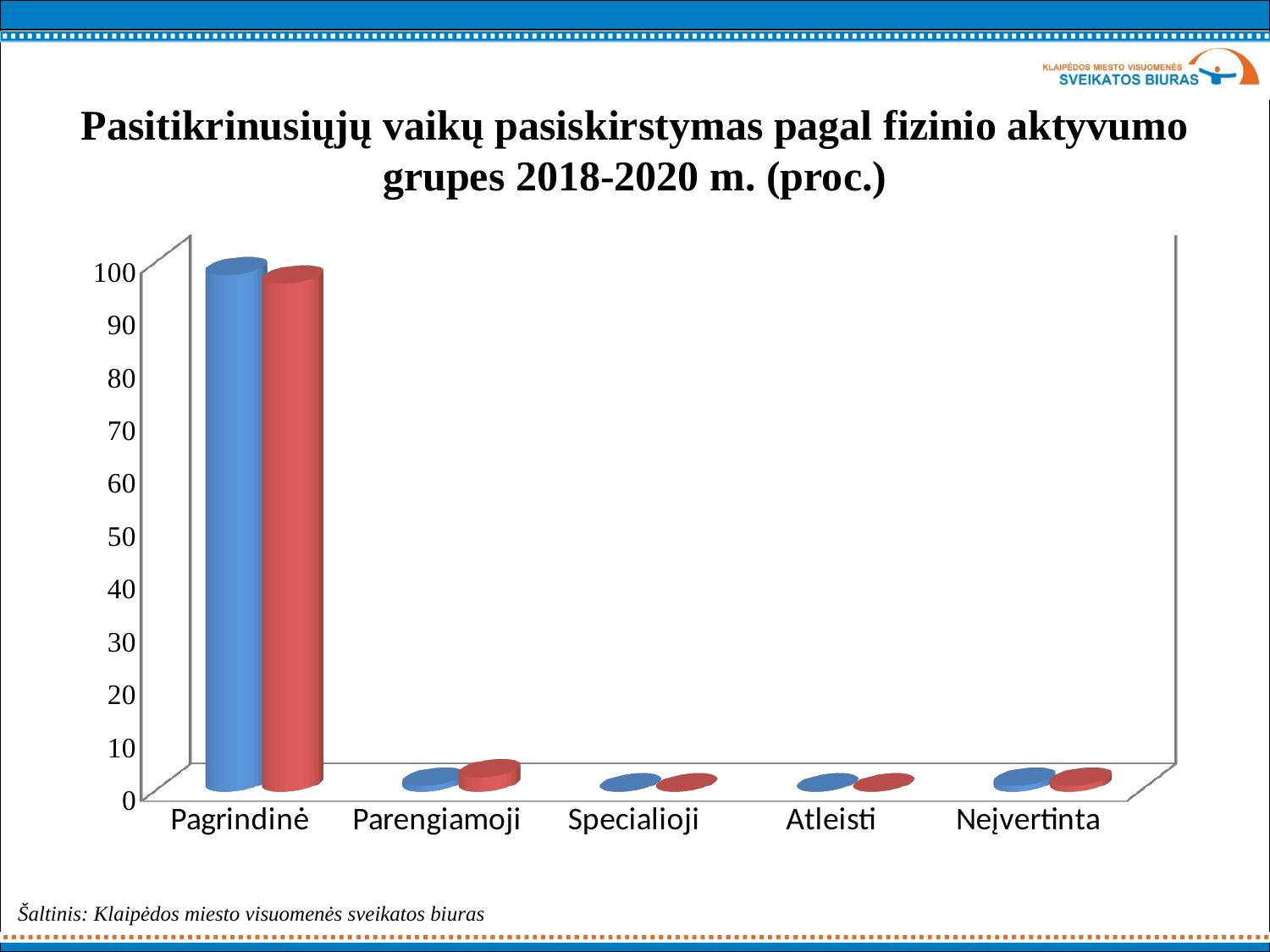
Which category has a larger blue bar, Pagrindinė or Neįvertinta? Pagrindinė How many categories are shown on the x axis of the chart? 5 What is the title of the chart? Pasitikrinusiųjų vaikų pasiskirstymas pagal fizinio aktyvumo grupes 2018-2020 m. (proc.) Is the value of the blue bar for Specialioji greater or less than 10? less Is the value of the red bar for Pagrindinė greater or less than 80? greater Which category has the highest values in the chart? Pagrindinė What kind of chart is shown on the slide? bar chart Is the value of the blue bar for Pagrindinė greater or less than 90? greater Which category has a larger red bar, Parengiamoji or Pagrindinė? Pagrindinė How many bars are shown for each category in the chart? 2